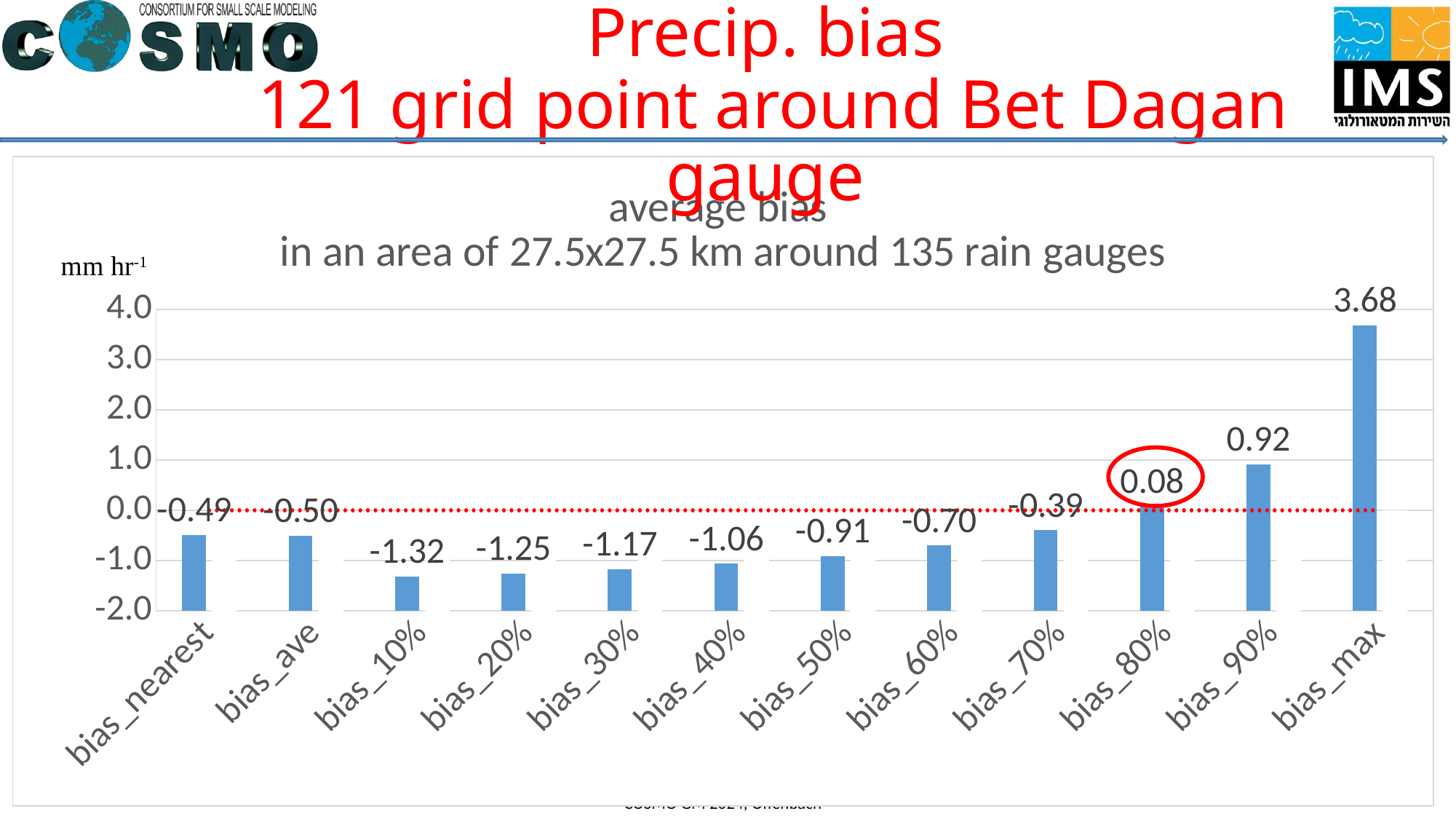
What is the difference between the values for bias_max and bias_90%? 2.76 What unit is shown at the top left of the chart's y axis? mm hr-1 Which category has the lowest value? bias_10% What is the value for bias_max? 3.68 What kind of chart is shown? bar chart How many categories are shown on the x axis? 12 What is the value for bias_80%? 0.08 Do the values rise or fall from bias_10% to bias_max? rise Which is larger, the value for bias_70% or the value for bias_60%? bias_70% What is the value for bias_nearest? -0.49 Which category has the highest value? bias_max What is the value for bias_10%? -1.32